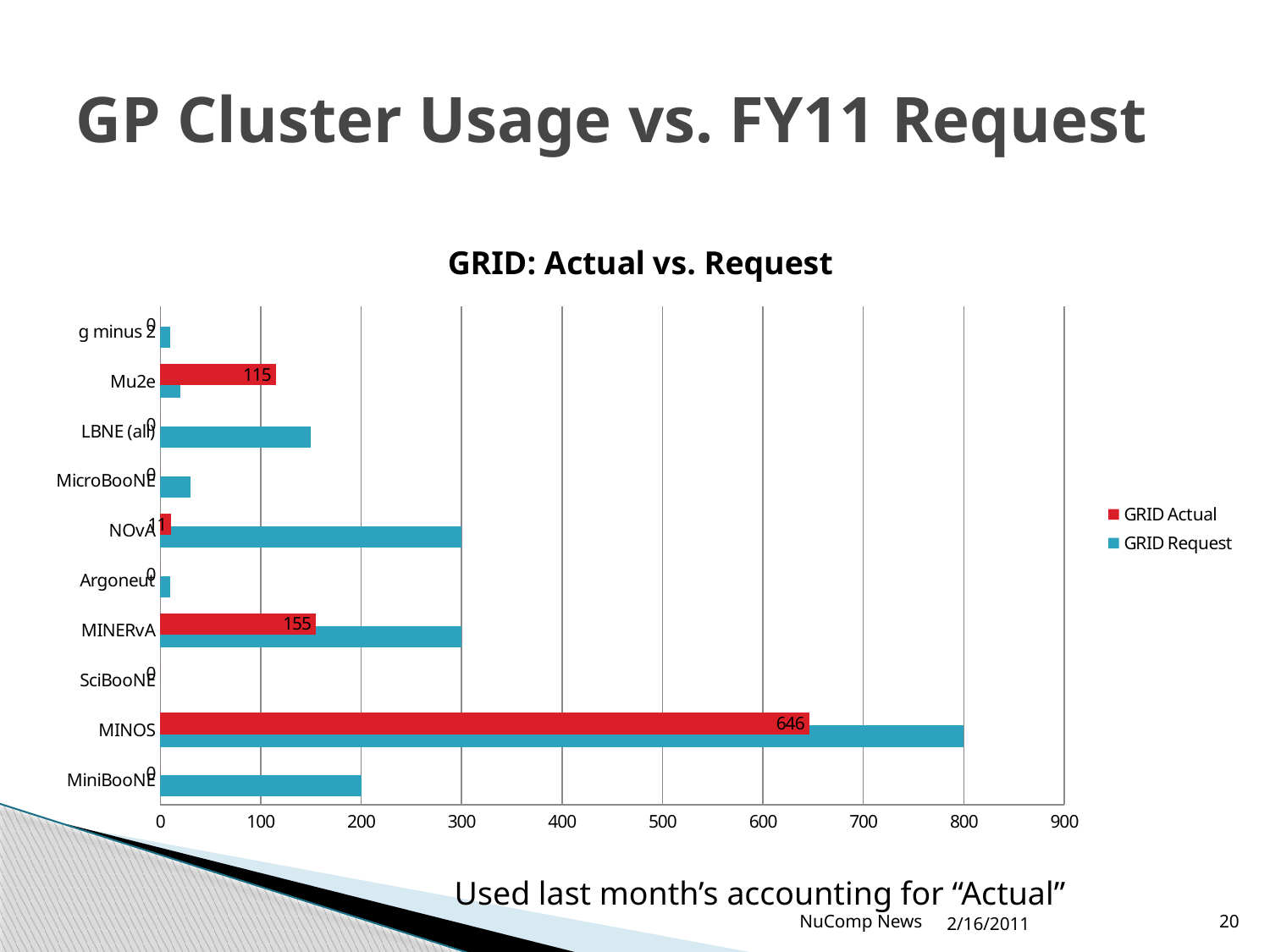
Which has a larger GRID Actual value, Mu2e or MINERvA? MINERvA Which experiment has the highest GRID Request value? MINOS Which experiment has the highest GRID Actual value? MINOS What is the GRID Actual value for Mu2e? 115 How many series does the legend list? 2 How many experiments are listed on the chart? 10 What is the GRID Actual value for NOvA? 11 Is the GRID Request value for LBNE (all) greater or less than 100? greater What is the GRID Actual value for MINOS? 646 Is the GRID Request value for MicroBooNE greater or less than 100? less What is the GRID Actual value for MINERvA? 155 What is the difference between the GRID Actual values for MINOS and MINERvA? 491